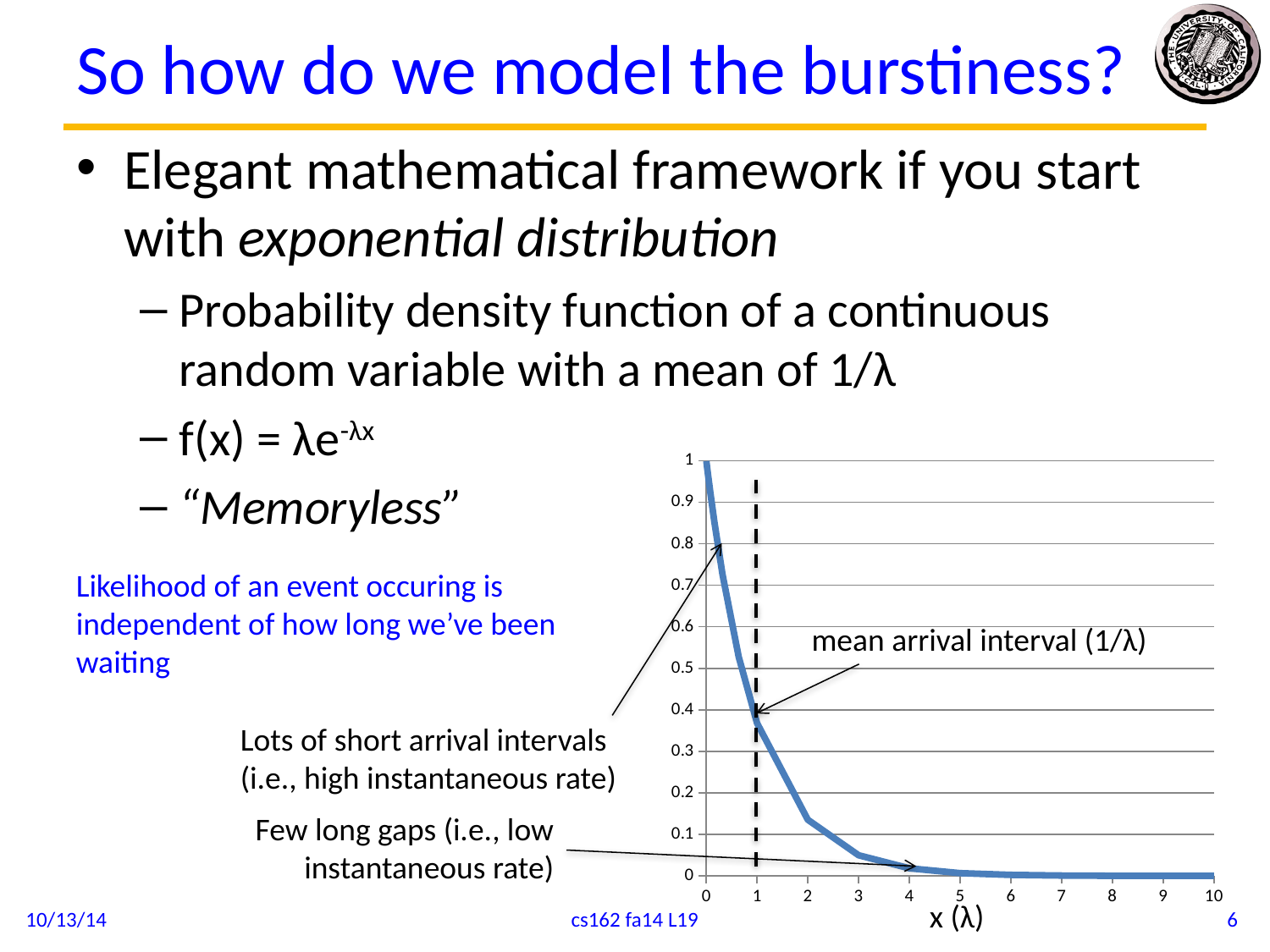
How many tick labels are shown on the x axis? 11 At which x value is the plotted curve highest? 0 At which x value is the dashed vertical line marking the mean arrival interval (1/λ) drawn? 1 What is the highest value labelled on the y axis? 1 Is the plotted value at x = 1 greater or less than 0.5? less Is the plotted value at x = 5 greater or less than 0.1? less Is the plotted value at x = 2 greater or less than 0.2? less Which has the larger plotted value, x = 1 or x = 5? x = 1 What is the label on the x axis of the chart? x (λ) What kind of chart is shown on the slide? line chart Do the plotted values rise or fall as x increases along the x axis? fall